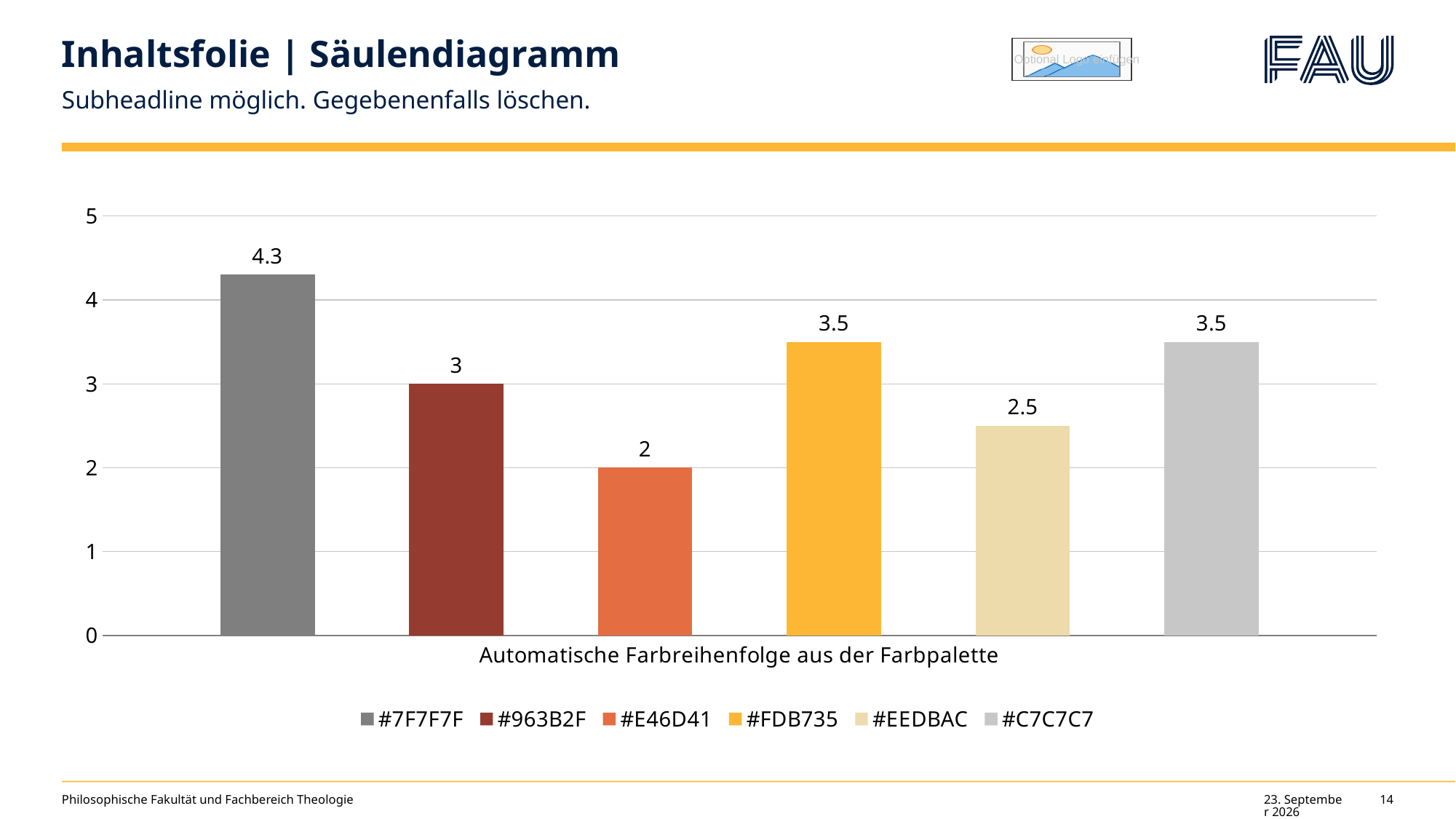
What is the value of the #7F7F7F series? 4.3 What is the value of the #E46D41 series? 2 How many series does the legend list? 6 Which series has the lowest value? #E46D41 What is the value of the #EEDBAC series? 2.5 What is the difference between the values of #FDB735 and #EEDBAC? 1 What is the difference between the values of #7F7F7F and #963B2F? 1.3 What kind of chart is shown on the slide? Bar chart Which series has the highest value? #7F7F7F What is the category label shown on the x axis? Automatische Farbreihenfolge aus der Farbpalette Which is larger, the value for #963B2F or the value for #E46D41? #963B2F What is the value of the #963B2F series? 3